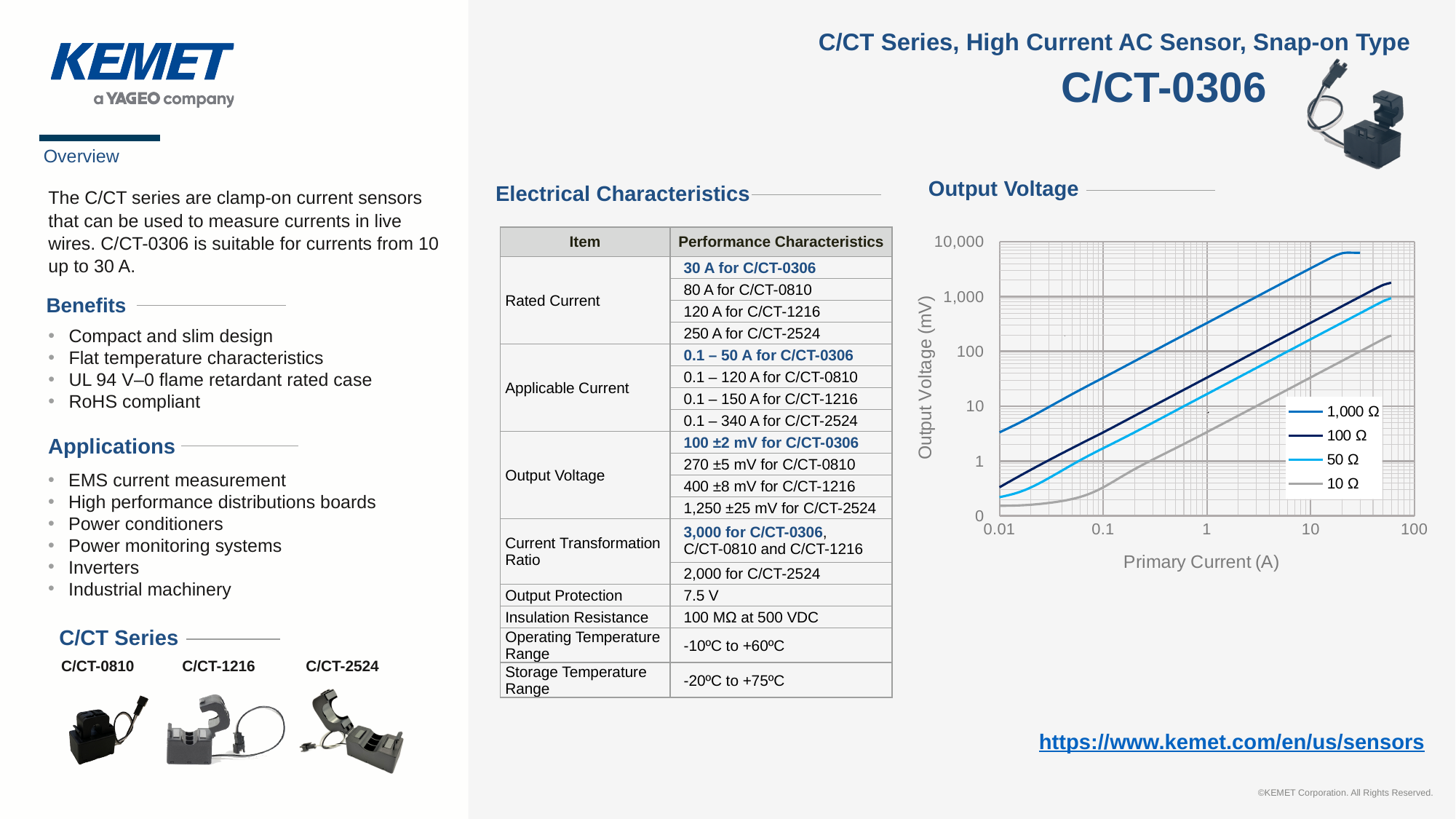
On the Output Voltage chart, which series has the highest output voltage across the primary current range? 1,000 Ω On the Output Voltage chart, is the output voltage of the 1,000 Ω series at 1 A greater or less than 100 mV? greater How many series does the legend of the Output Voltage chart list? 4 What kind of chart is the Output Voltage chart? line chart On the Output Voltage chart, which series has the lowest output voltage across the primary current range? 10 Ω On the Output Voltage chart, is the output voltage of the 1,000 Ω series at 10 A greater or less than 1,000 mV? greater On the Output Voltage chart, at a primary current of 1 A, which series has the larger output voltage, 100 Ω or 50 Ω? 100 Ω What is the label of the y axis on the Output Voltage chart? Output Voltage (mV) On the Output Voltage chart, does the output voltage rise or fall as primary current increases? rise What is the label of the x axis on the Output Voltage chart? Primary Current (A) On the Output Voltage chart, is the output voltage of the 100 Ω series at 0.01 A greater or less than 1 mV? less